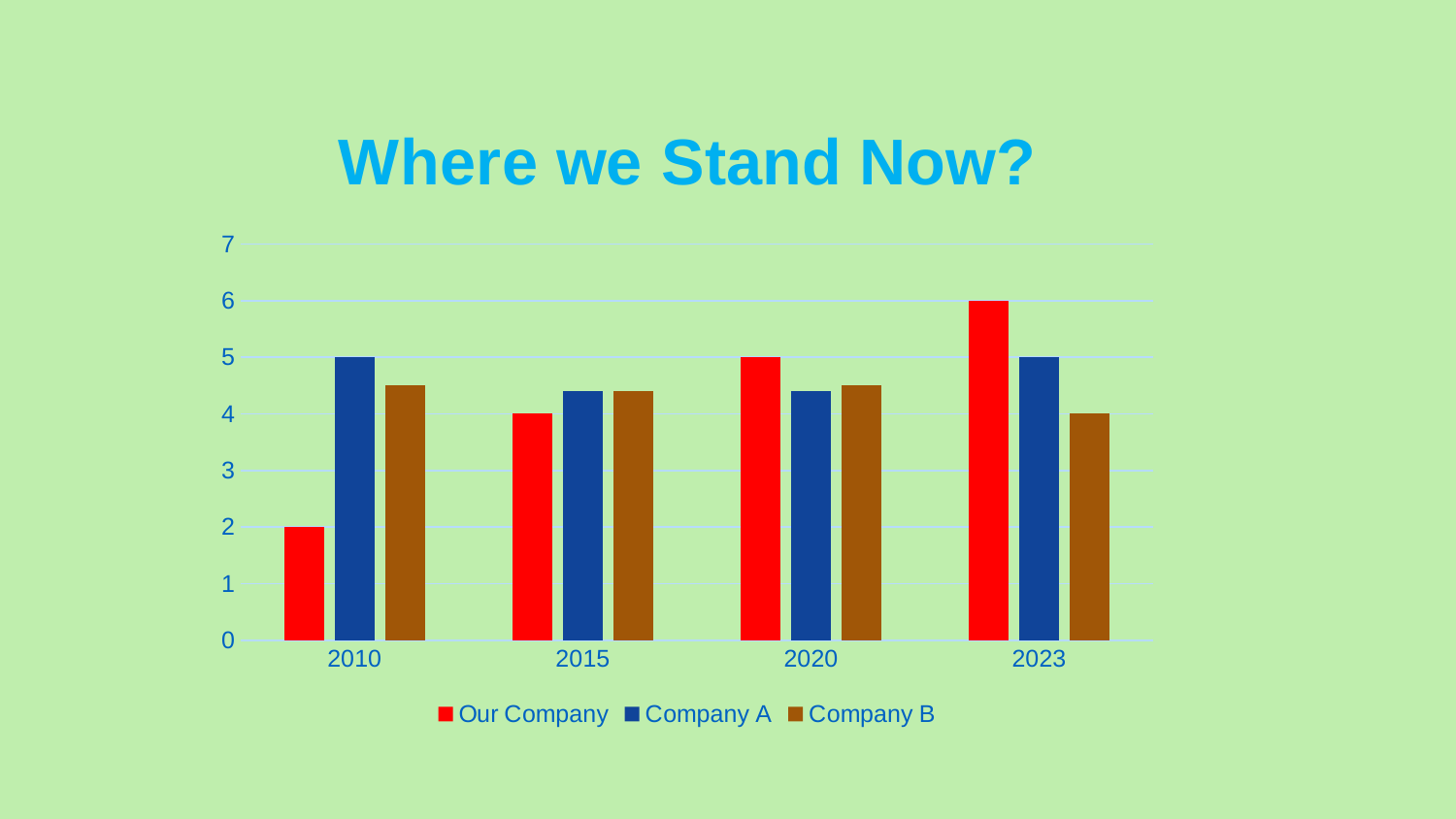
Is the value for Company B in 2010 greater or less than 4? greater In which year is the value for Our Company lowest? 2010 In which year is the value for Our Company highest? 2023 What is the value for Our Company in 2010? 2 How many year categories are shown on the x axis? 4 What kind of chart is shown on the slide? bar chart Do the values for Our Company rise or fall from 2010 to 2023? rise What is the value for Our Company in 2023? 6 How many series does the legend list? 3 What is the title of the chart? Where we Stand Now? What is the difference between the Our Company values for 2023 and 2010? 4 What is the value for Company A in 2010? 5